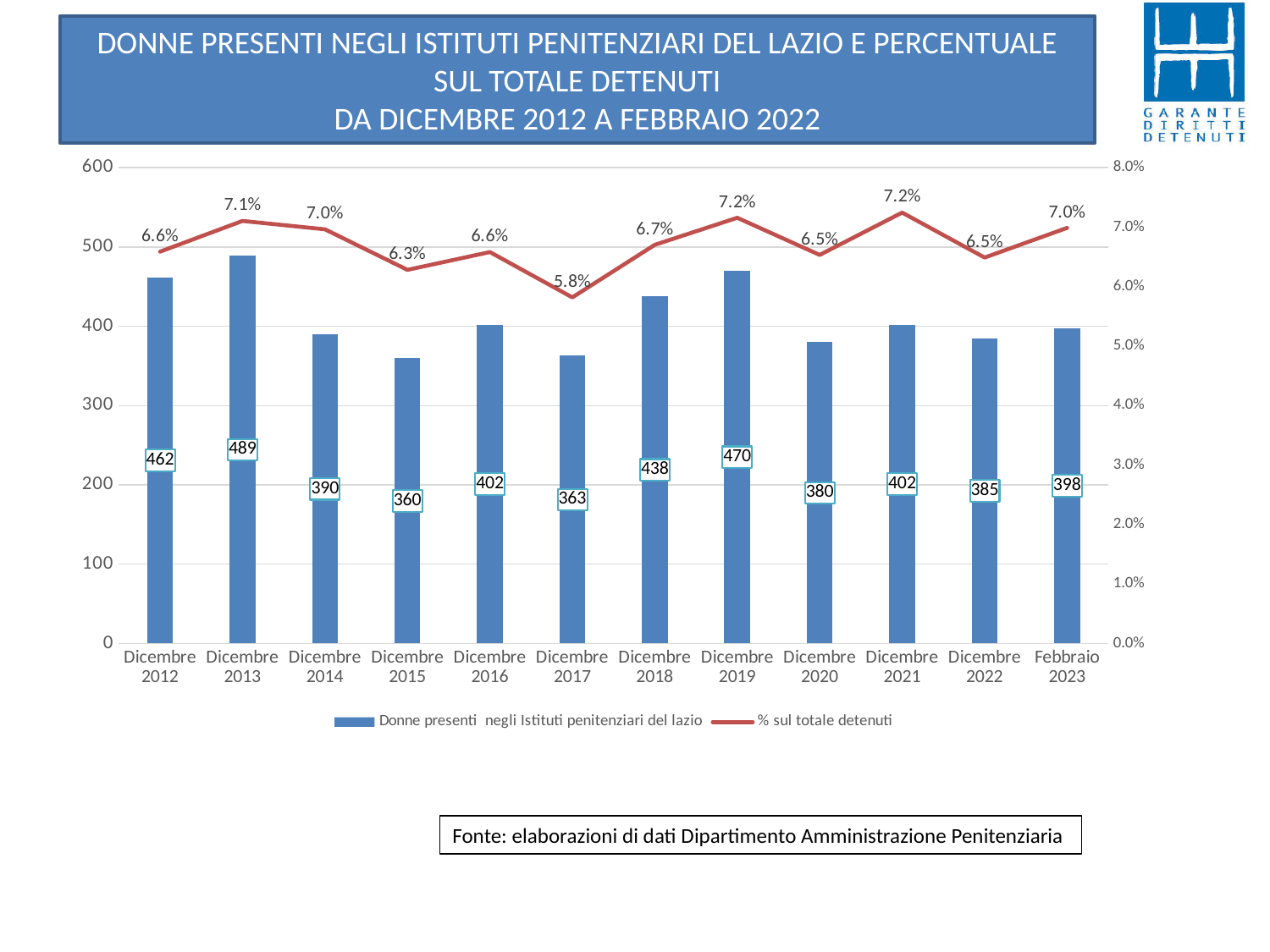
Which period has the lowest percentage of women on the total detainees? Dicembre 2017 What colour is the line showing '% sul totale detenuti'? Red Which period has the lowest number of women present in Lazio penitentiary institutions? Dicembre 2015 How many periods are shown on the x axis of the chart? 12 What is the percentage of women on the total detainees in Dicembre 2017? 5.8% What kind of chart is used for the series 'Donne presenti negli Istituti penitenziari del lazio'? Bar chart Which is larger, the number of women present in Dicembre 2019 or in Dicembre 2018? Dicembre 2019 Which period has the highest number of women present in Lazio penitentiary institutions? Dicembre 2013 What is the difference between the number of women present in Dicembre 2013 and Dicembre 2015? 129 How many series does the legend list? 2 How many women were present in Lazio penitentiary institutions in Dicembre 2013? 489 Does the number of women present rise or fall from Dicembre 2019 to Dicembre 2020? Fall